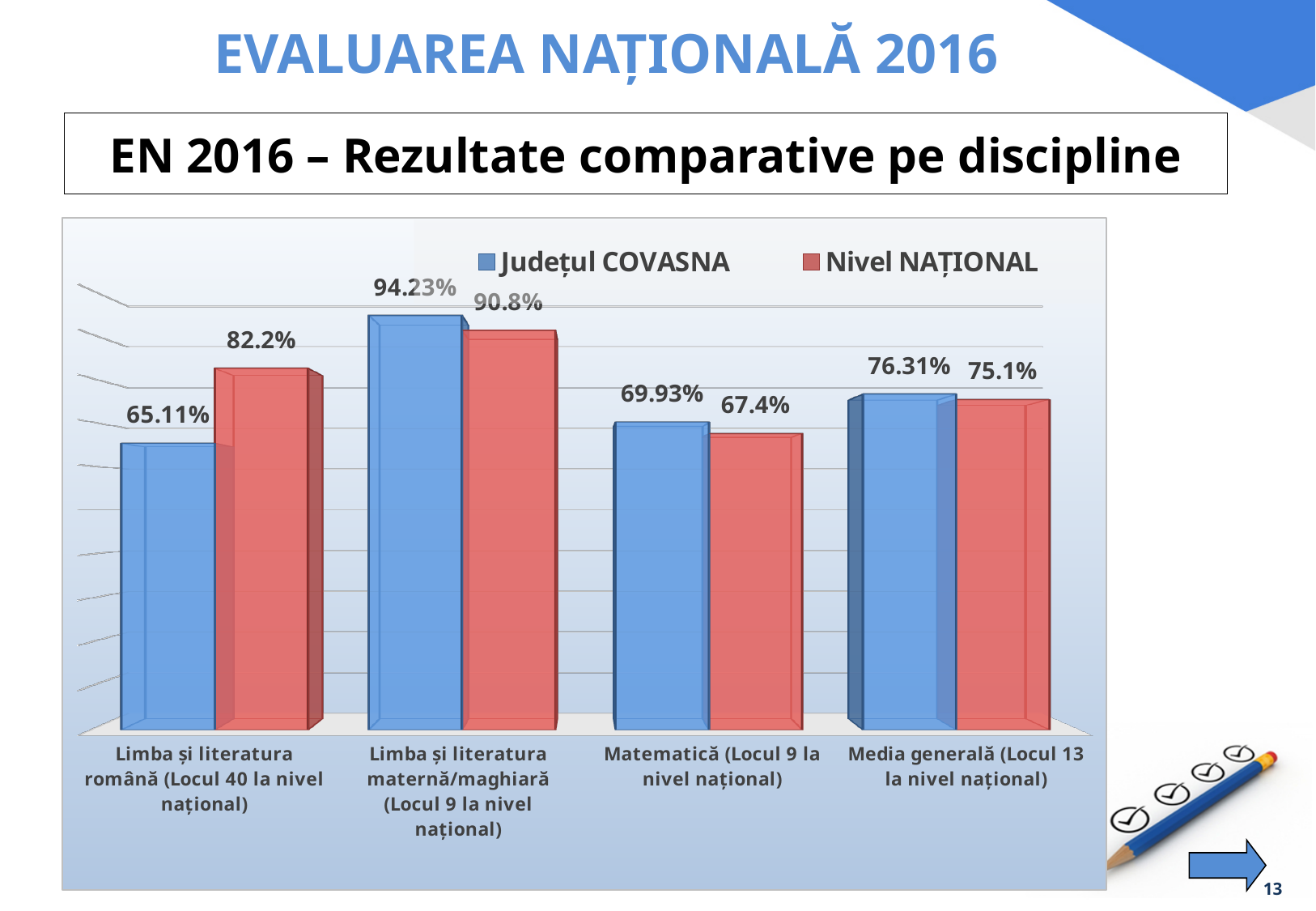
Which category has the highest value for Județul COVASNA? Limba și literatura maternă/maghiară Which is larger in Matematică: Județul COVASNA or Nivel NAȚIONAL? Județul COVASNA What is the value for Județul COVASNA in Limba și literatura maternă/maghiară? 94.23% How many categories are shown on the x axis? 4 How many series does the legend list? 2 What is the value for Județul COVASNA in Limba și literatura română? 65.11% What is the difference between Nivel NAȚIONAL and Județul COVASNA in Limba și literatura română? 17.09% What is the value for Nivel NAȚIONAL in Matematică? 67.4% What kind of chart is shown on the slide? Bar chart What is the value for Județul COVASNA in Media generală? 76.31% Which category has the lowest value for Nivel NAȚIONAL? Matematică What is the value for Nivel NAȚIONAL in Limba și literatura română? 82.2%